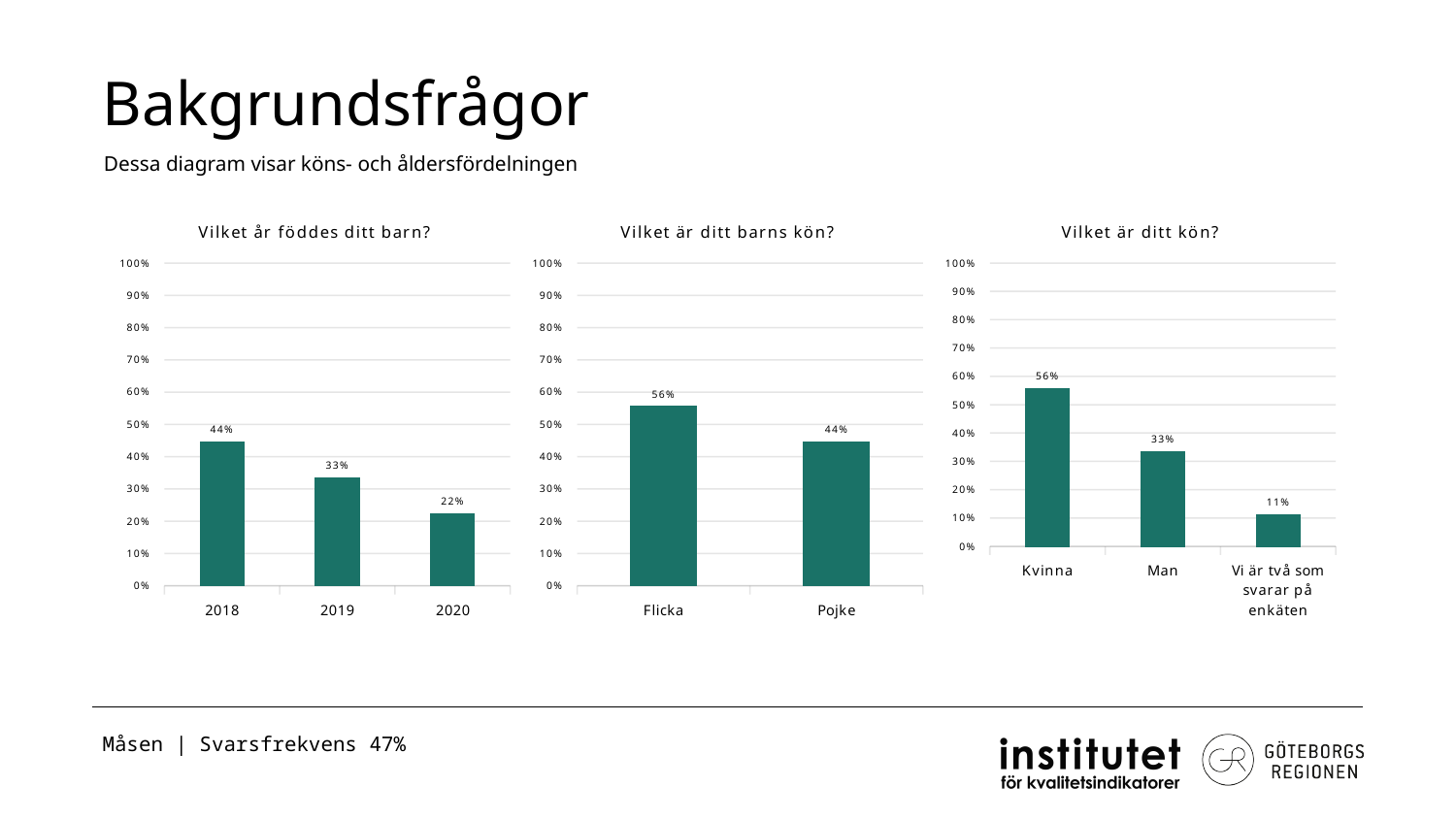
In the chart 'Vilket är ditt barns kön?', what is the value for Flicka? 56% In the chart 'Vilket år föddes ditt barn?', which year has the highest value? 2018 How many charts are shown on the slide? 3 In the chart 'Vilket är ditt kön?', what is the difference between the values for Kvinna and Man? 23% What kind of chart is 'Vilket är ditt kön?'? bar chart In the chart 'Vilket år föddes ditt barn?', what is the value for 2019? 33% In the chart 'Vilket år föddes ditt barn?', do the values rise or fall from 2018 to 2020? fall In the chart 'Vilket är ditt kön?', what is the value for 'Vi är två som svarar på enkäten'? 11% In the chart 'Vilket är ditt barns kön?', which is larger, Flicka or Pojke? Flicka In the chart 'Vilket är ditt kön?', which category has the lowest value? Vi är två som svarar på enkäten In the chart 'Vilket är ditt barns kön?', how many categories are shown? 2 In the chart 'Vilket år föddes ditt barn?', what is the difference between the values for 2018 and 2020? 22%